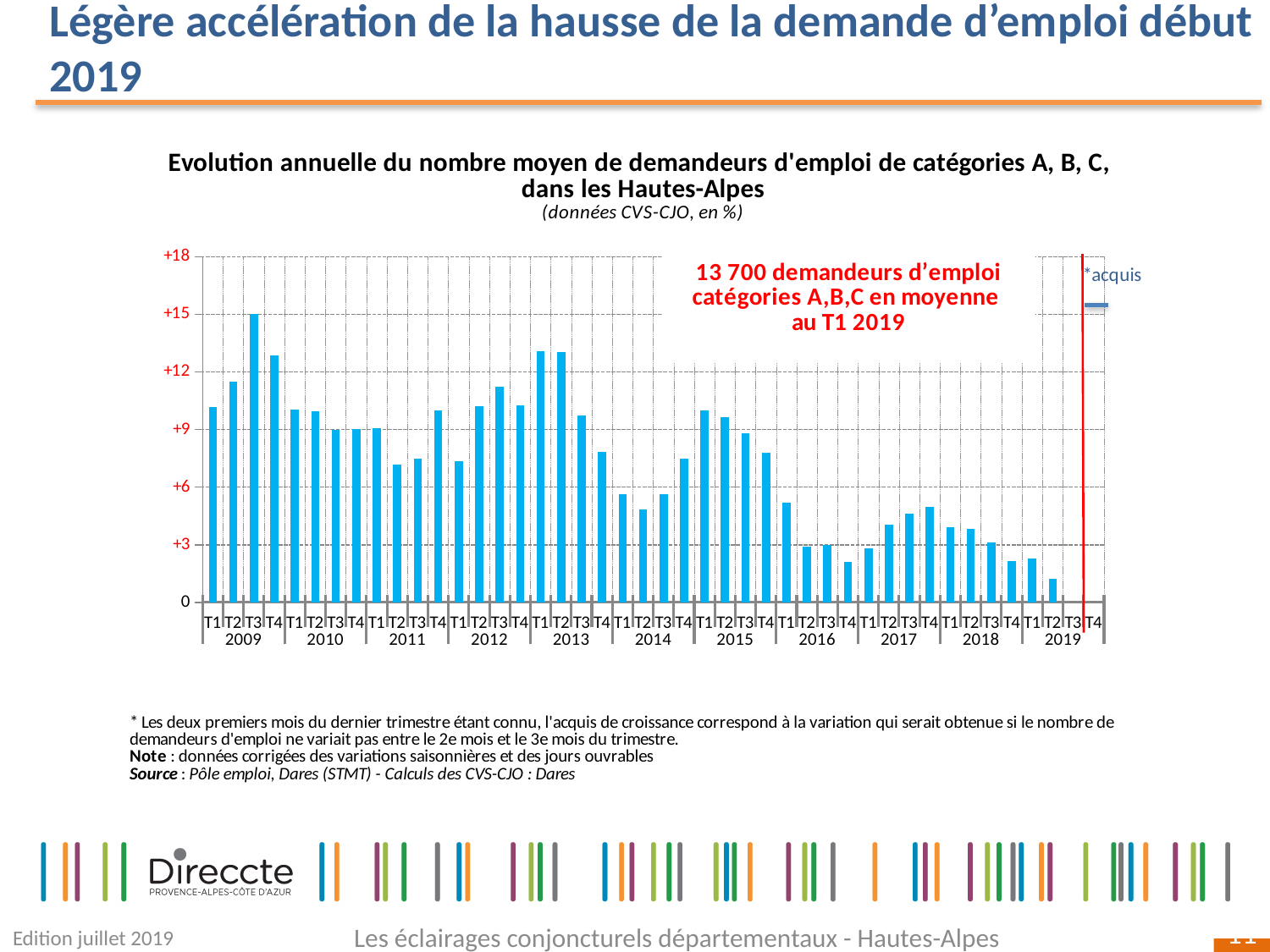
What kind of chart is shown on the slide? bar chart How many years are labelled on the x axis of the chart? 11 Is the value for T4 2016 greater or less than +3? less Which is larger, the value for T1 2015 or the value for T1 2016? T1 2015 Which quarter has the highest value in the chart? T3 2009 Is the value for T2 2019 greater or less than +3? less Is the value for T3 2009 greater or less than +12? greater Overall, do the values rise or fall from 2009 to 2019? fall According to the annotation on the chart, how many job seekers in categories A, B, C were there on average in T1 2019? 13 700 Which quarter has the lowest value in the chart? T2 2019